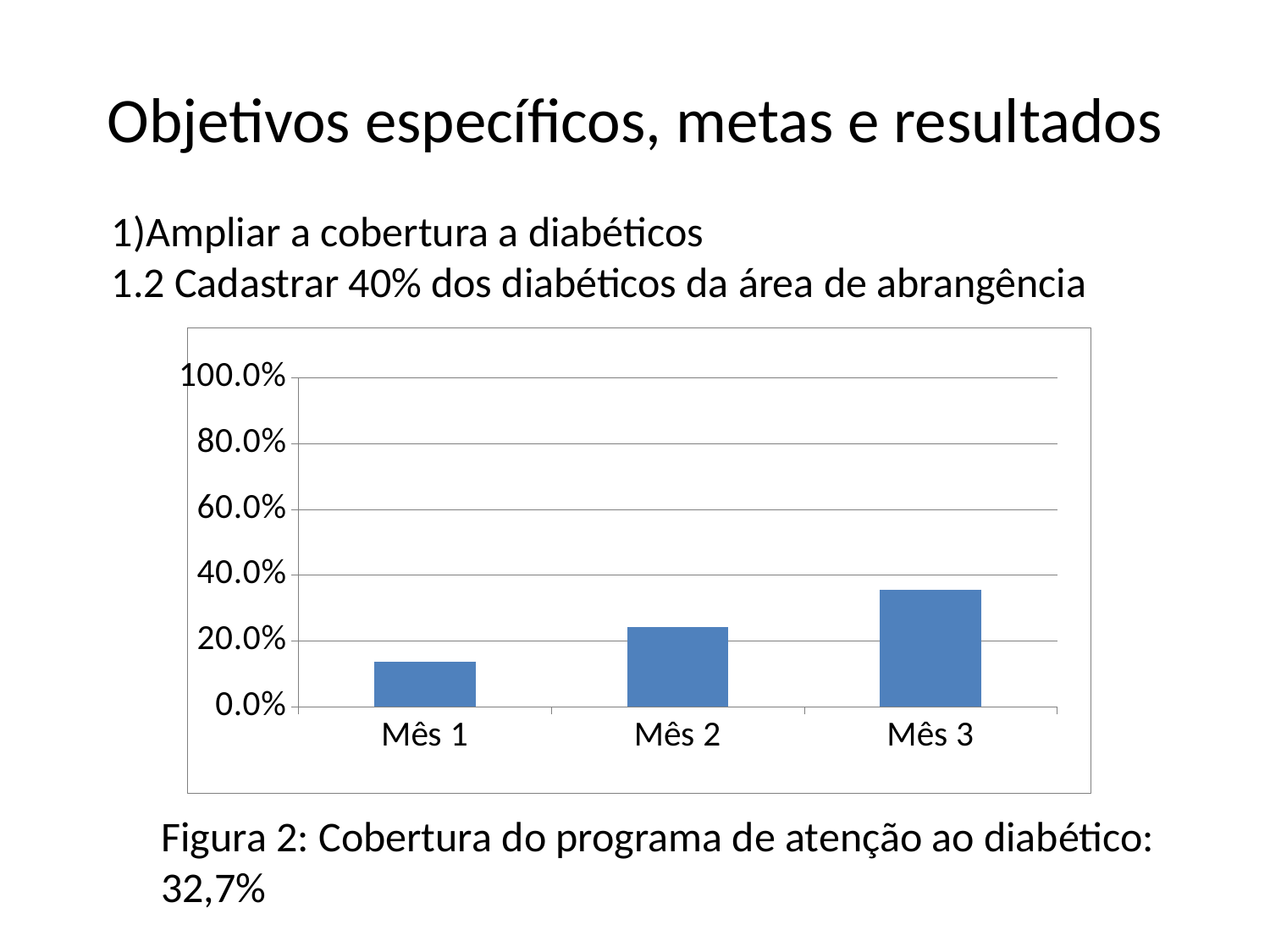
Which month has the lowest bar in the chart? Mês 1 Is the value for Mês 1 greater or less than 20.0%? less Which month has the highest bar in the chart? Mês 3 Which is larger, the value for Mês 3 or the value for Mês 2? Mês 3 What kind of chart is shown on the slide? bar chart How many categories are shown on the x axis of the chart? 3 What coverage percentage is stated in the figure caption below the chart? 32,7% Is the value for Mês 2 greater or less than 20.0%? greater Do the values rise or fall from Mês 1 to Mês 3? rise Is the value for Mês 3 greater or less than 40.0%? less Which is larger, the value for Mês 2 or the value for Mês 1? Mês 2 What is the highest value shown on the chart's vertical axis? 100.0%